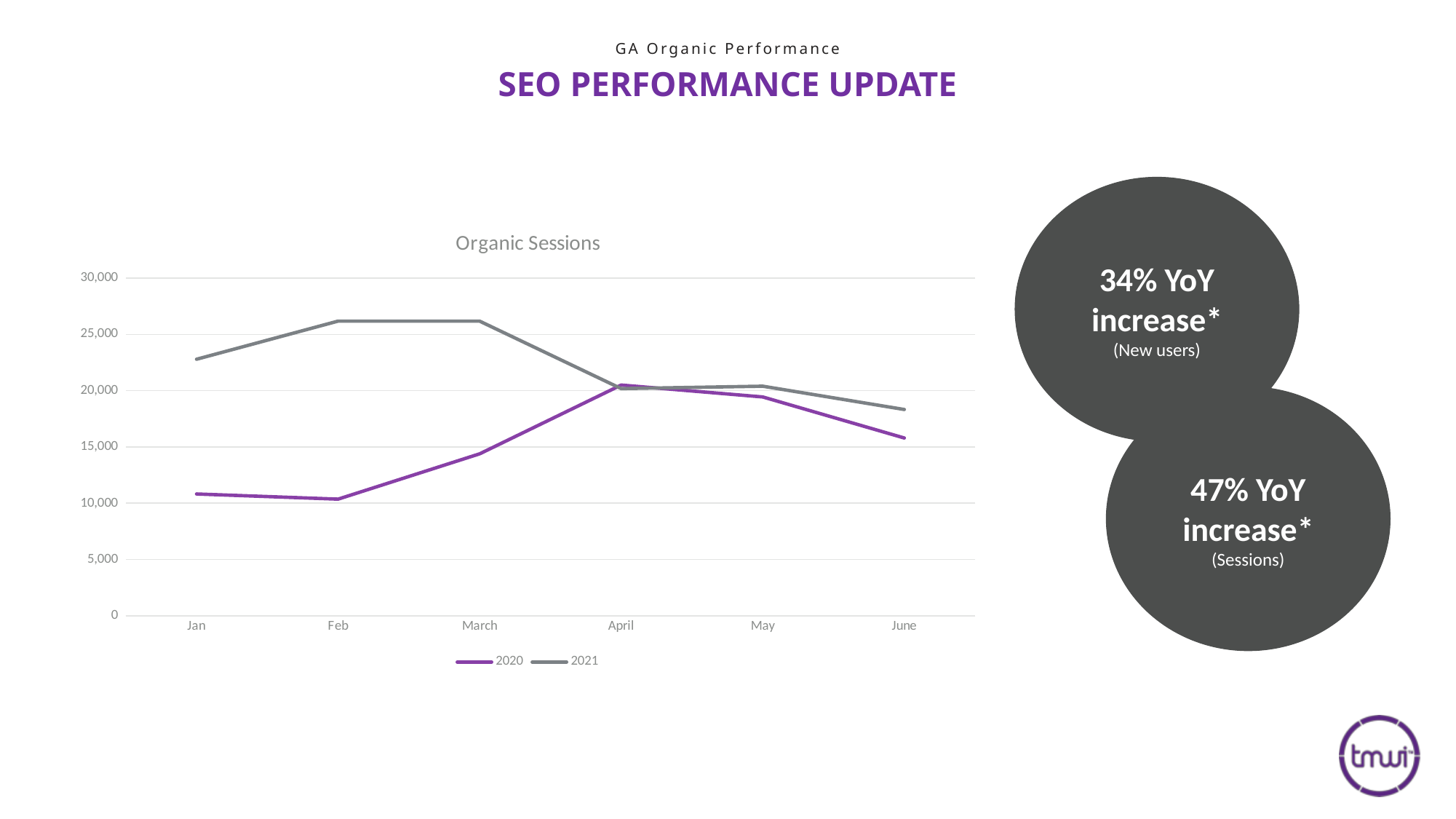
In which month does the 2020 series reach its highest value? April Does the 2021 series rise or fall from March to June? Fall In Jan, which series has the larger value, 2020 or 2021? 2021 Is the value for 2020 in Jan greater or less than 15,000? less Which colour represents the 2020 series in the chart? Purple How many series does the legend of the Organic Sessions chart list? 2 In which month does the 2021 series reach its lowest value? June Is the value for 2021 in Feb greater or less than 25,000? greater What is the title of the chart? Organic Sessions How many months are plotted along the x axis of the Organic Sessions chart? 6 What kind of chart is shown on the slide? Line chart Is the value for 2021 in June greater or less than 15,000? greater